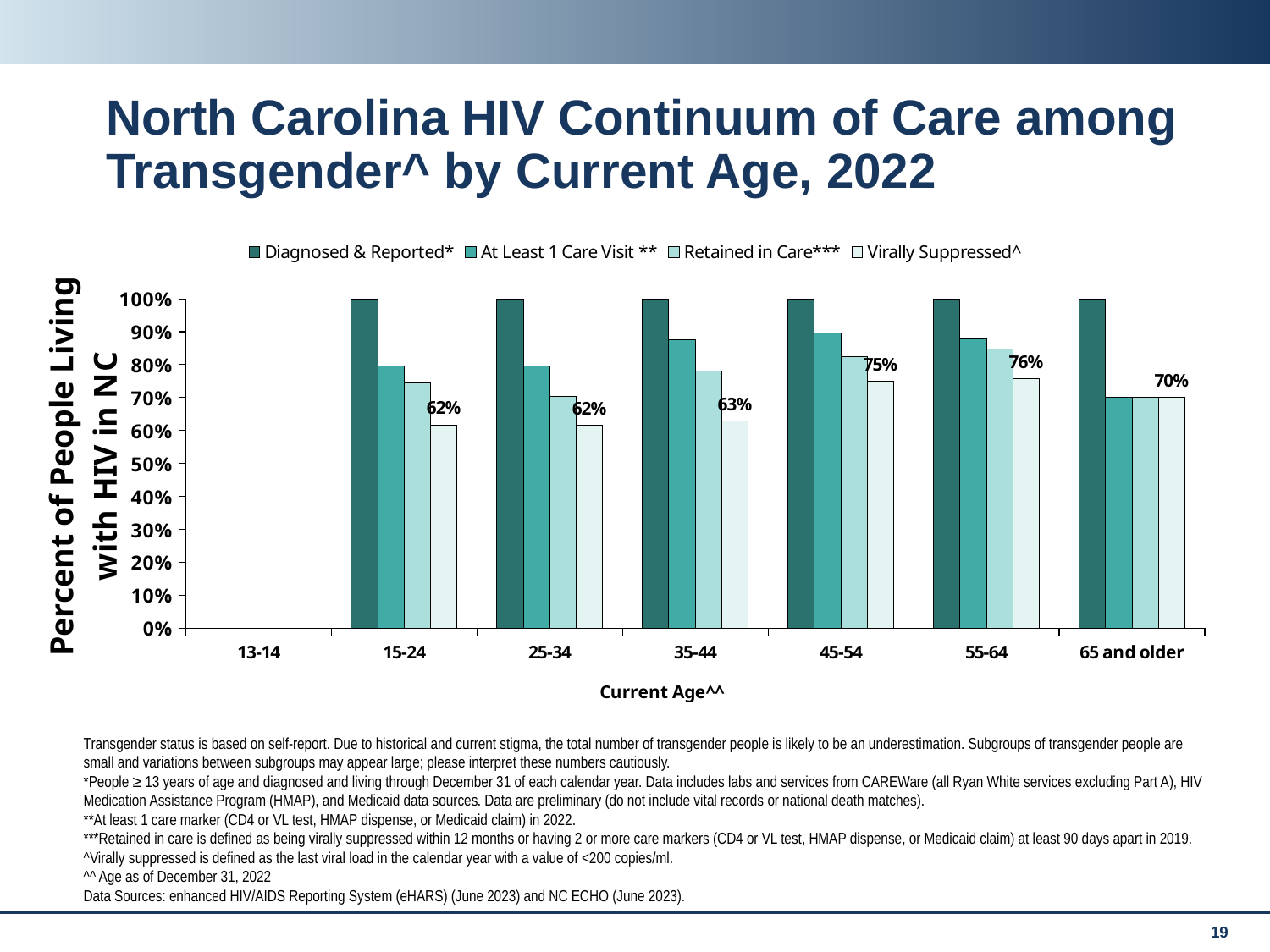
What kind of chart is shown on the slide? bar chart Is the At Least 1 Care Visit ** value for the 15-24 age group greater or less than 70%? greater Is the Retained in Care*** value for the 25-34 age group greater or less than 80%? less What is the difference between the Virally Suppressed^ values for the 55-64 and 15-24 age groups? 14 percentage points What is the Diagnosed & Reported* value for the 35-44 age group? 100% Which age group has the highest Virally Suppressed^ value? 55-64 What is the Virally Suppressed^ value for the 15-24 age group? 62% How many age groups are shown on the x axis? 7 Which has a higher Virally Suppressed^ value: the 35-44 age group or the 65 and older age group? 65 and older What is the title of the x axis? Current Age^^ What is the Virally Suppressed^ value for the 45-54 age group? 75% How many series does the legend list? 4